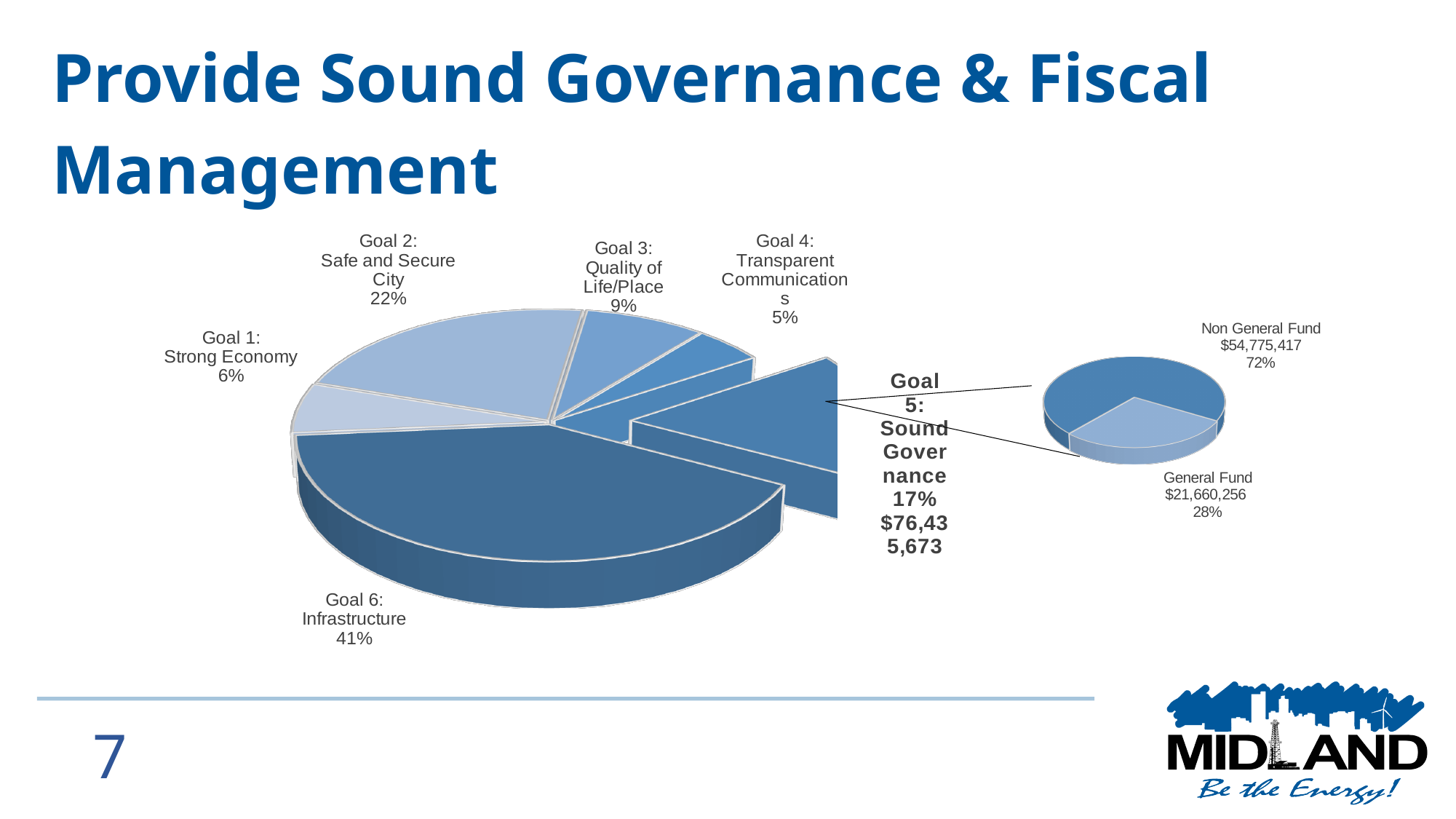
In the smaller pie breaking down Goal 5, what dollar amount is shown for the General Fund? $21,660,256 What percentage share does Goal 2: Safe and Secure City have in the main pie? 22% How many goals are shown as slices in the main pie? 6 What kind of chart is shown on the slide? Pie chart What percentage share does Goal 6: Infrastructure have in the main pie? 41% What dollar amount is shown for Goal 5: Sound Governance? $76,435,673 Which has a larger share of the main pie, Goal 1: Strong Economy or Goal 3: Quality of Life/Place? Goal 3: Quality of Life/Place Which goal has the largest share of the main pie? Goal 6: Infrastructure In the smaller pie breaking down Goal 5, what is the difference in dollars between the Non General Fund and the General Fund? $33,115,161 Which goal has the smallest share of the main pie? Goal 4: Transparent Communications What is the difference in percentage points between Goal 2: Safe and Secure City and Goal 3: Quality of Life/Place? 13% In the smaller pie breaking down Goal 5, what percentage share does the Non General Fund have? 72%